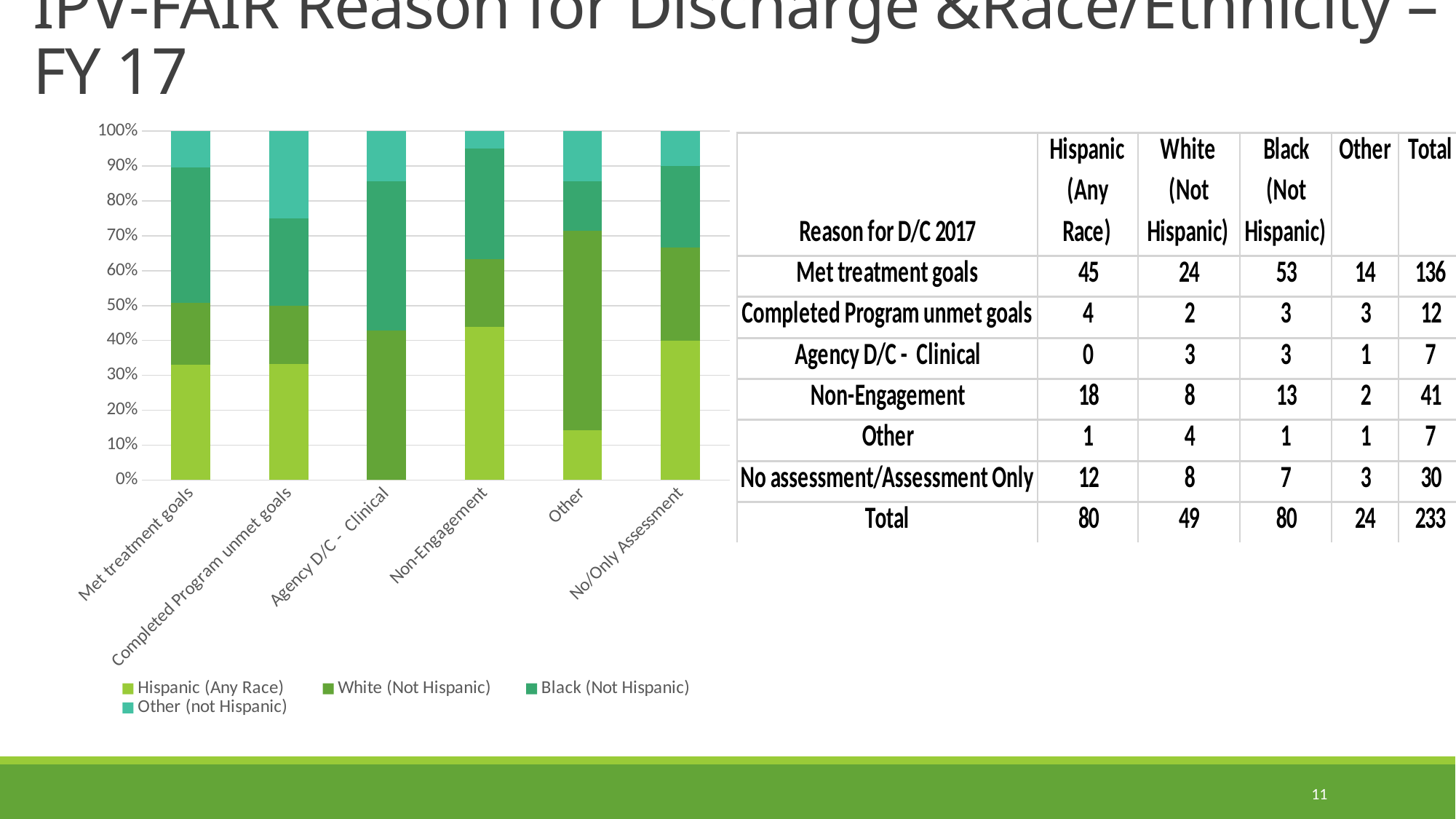
How many discharge-reason categories are plotted along the x axis of the chart? 6 Which series is shown in the lightest green at the bottom of each bar? Hispanic (Any Race) In the chart, is the Hispanic (Any Race) share larger for Non-Engagement or for Other? Non-Engagement According to the table, what is the total number of clients who Met treatment goals? 136 In the chart, is the Hispanic (Any Race) share for the Other category greater or less than 20%? less In the chart, is the Other (not Hispanic) share for Completed Program unmet goals greater or less than 20%? greater According to the table, how many Black (Not Hispanic) clients were discharged for Non-Engagement? 13 How many series does the chart legend list? 4 What kind of chart is shown on the slide? Stacked bar chart In the chart, which category has the smallest Hispanic (Any Race) segment? Agency D/C - Clinical In the chart, which category has the largest Other (not Hispanic) segment? Completed Program unmet goals